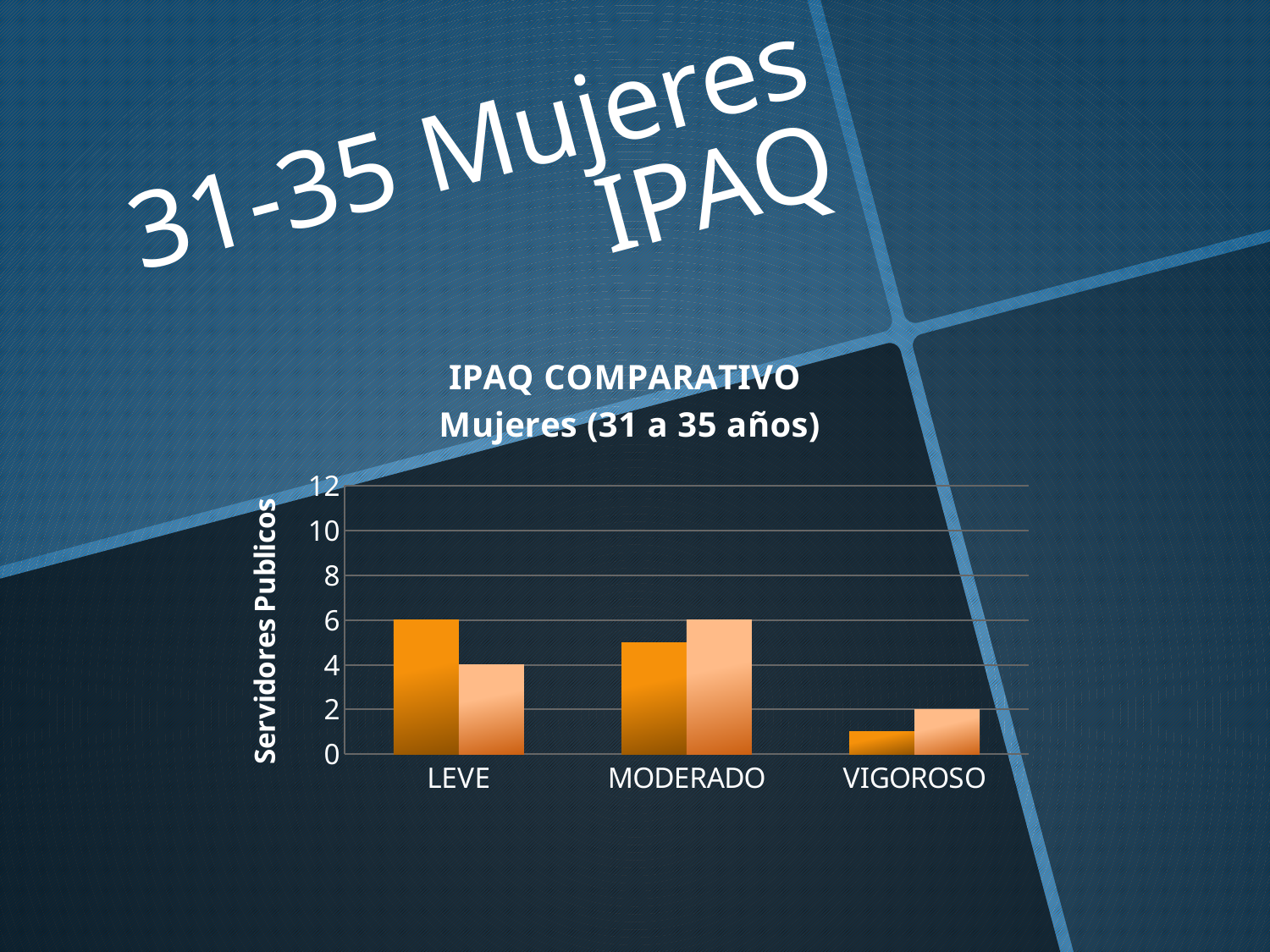
Is the value of the darker orange bar for MODERADO greater or less than 4? greater For LEVE, which bar is larger, the darker orange bar or the lighter orange bar? the darker orange bar Is the value of the darker orange bar for VIGOROSO greater or less than 2? less Among the darker orange bars, which category has the highest value? LEVE What is the value of the lighter orange bar for MODERADO? 6 What is the value of the lighter orange bar for LEVE? 4 What is the value of the lighter orange bar for VIGOROSO? 2 What is the title of the vertical axis of the chart? Servidores Publicos What is the value of the darker orange bar for LEVE? 6 How many categories are shown on the x axis of the chart? 3 What is the difference between the darker orange bar and the lighter orange bar for LEVE? 2 What kind of chart is shown on the slide? bar chart